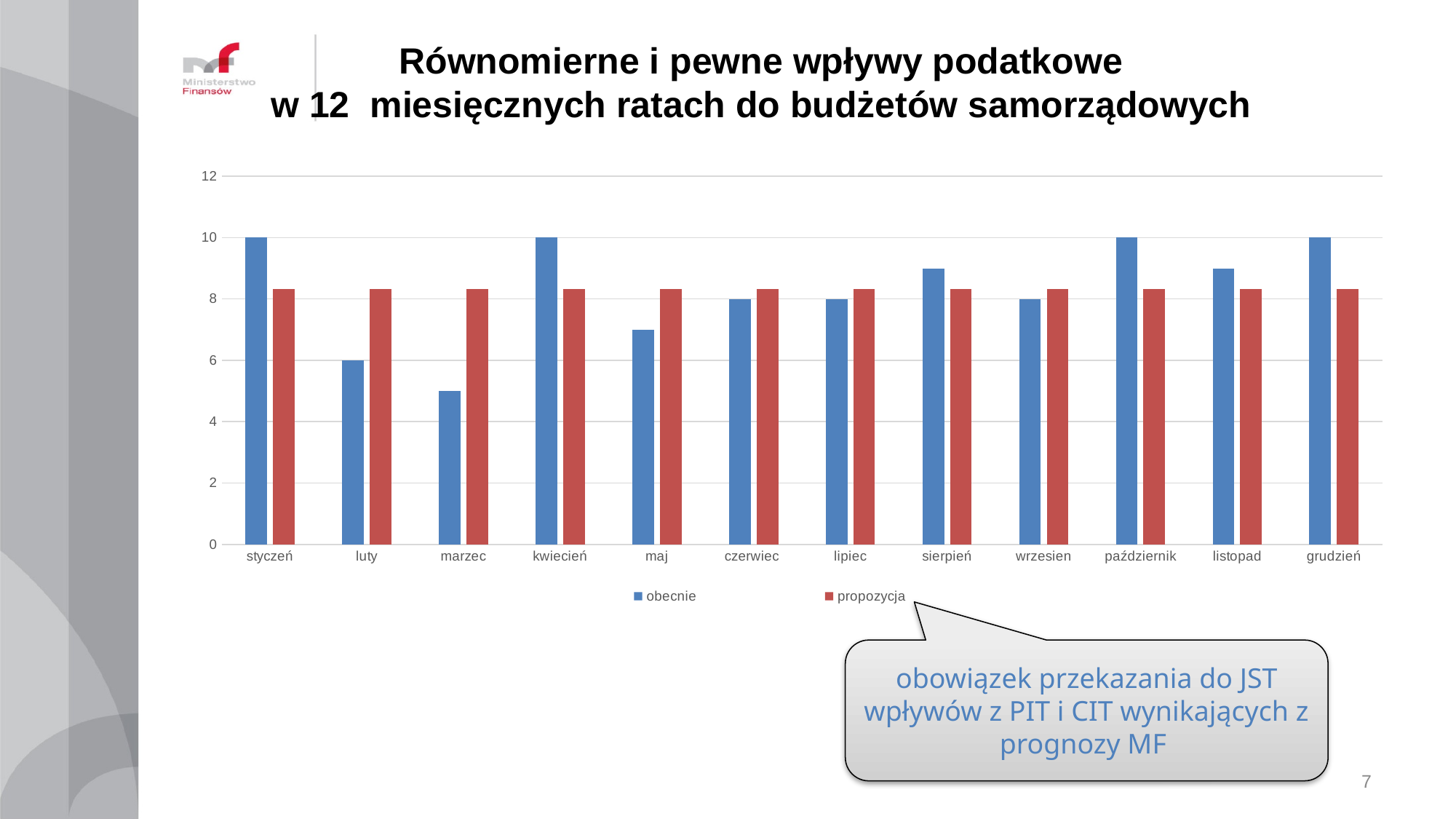
What type of chart is shown on the slide? bar chart What is the difference between the 'obecnie' values for styczeń and luty? 4 Is the 'propozycja' value for styczeń greater or less than 8? greater For luty, which series has the larger value, 'obecnie' or 'propozycja'? propozycja How many series does the legend list? 2 What is the value of the 'obecnie' bar for czerwiec? 8 Is the 'obecnie' value for marzec greater or less than 6? less How many months (categories) are shown on the x axis? 12 What are the two series named in the legend? obecnie, propozycja What is the value of the 'obecnie' bar for luty? 6 Which month has the lowest 'obecnie' value? marzec What is the value of the 'obecnie' bar for styczeń? 10